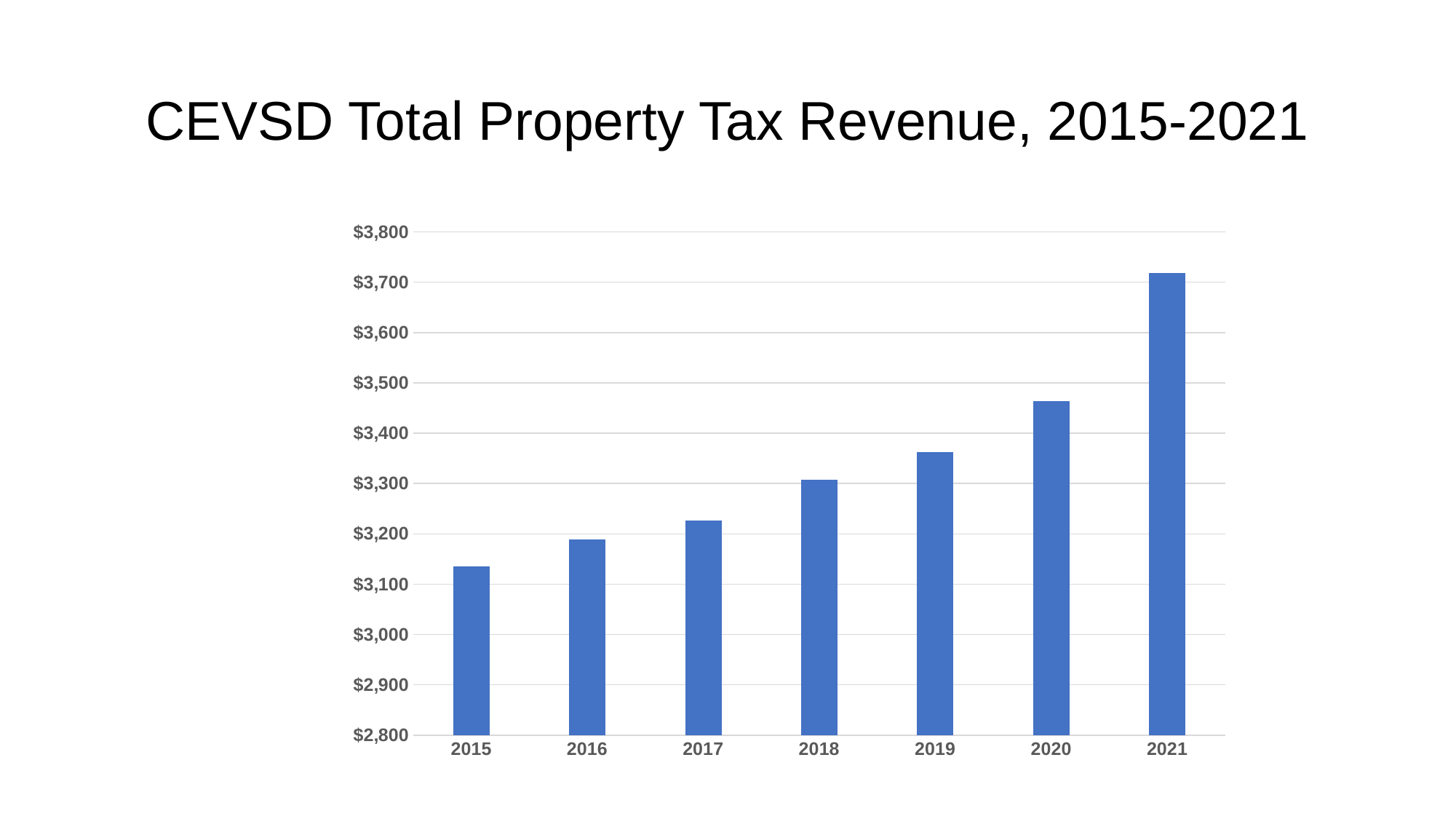
Is the value for 2019 greater or less than $3,300? greater What type of chart is shown on the slide? bar chart Is the value for 2020 greater or less than $3,500? less How many years are shown on the x axis of the chart? 7 Is the value for 2015 greater or less than $3,100? greater Which is larger, the value for 2017 or the value for 2020? 2020 Which year has the highest total property tax revenue? 2021 Which year has the lowest total property tax revenue? 2015 What is the title of the chart? CEVSD Total Property Tax Revenue, 2015-2021 Do the values rise or fall from 2015 to 2021? rise